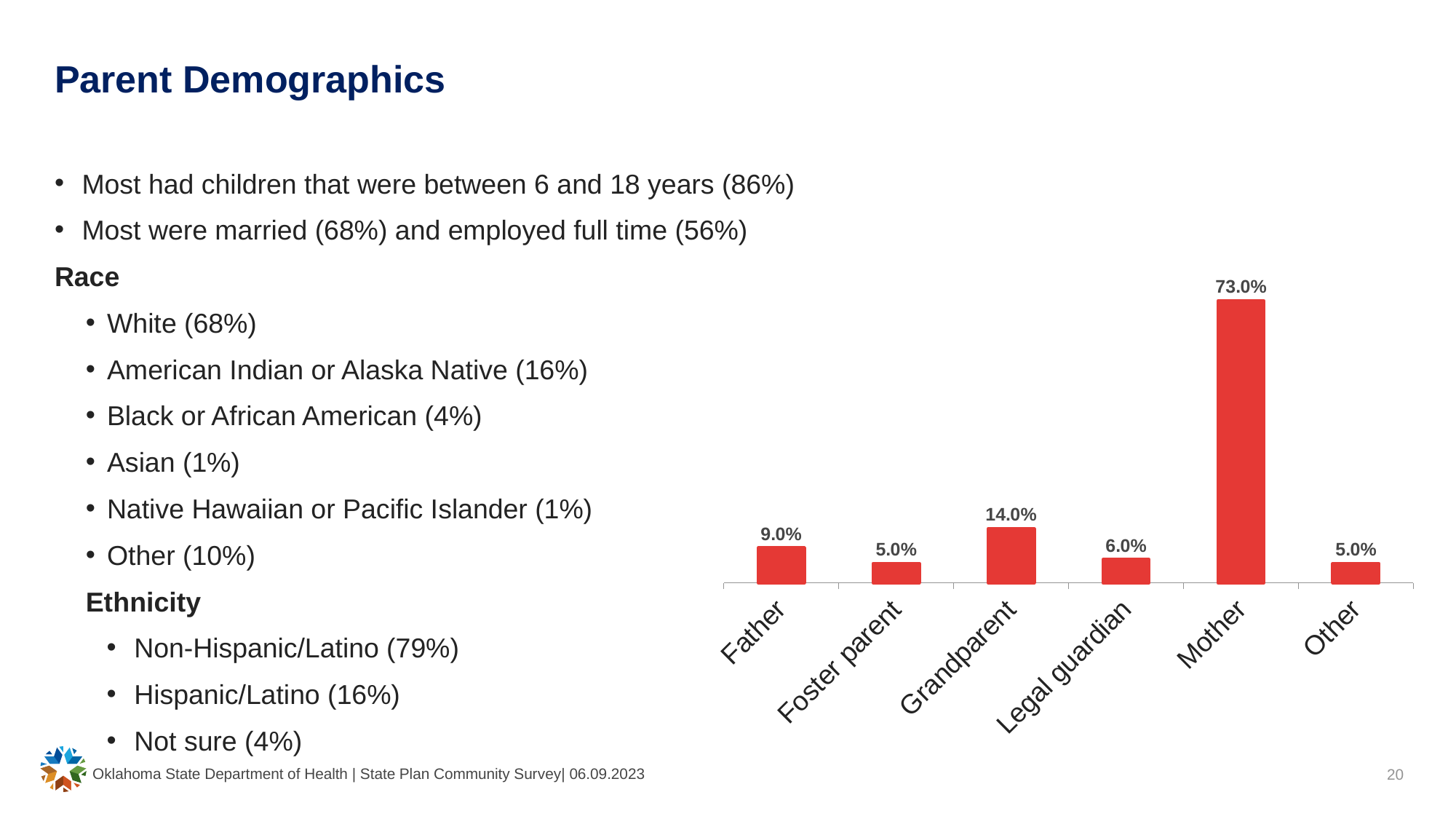
What is the value for Legal guardian in the bar chart? 6.0% What is the value for Father in the bar chart? 9.0% What is the value for Mother in the bar chart? 73.0% Which is larger, the value for Father or the value for Foster parent? Father What colour are the bars in the chart? Red Which category has the highest value in the bar chart? Mother How many categories are shown in the bar chart? 6 Which is larger, the value for Grandparent or the value for Legal guardian? Grandparent What is the value for Grandparent in the bar chart? 14.0% What kind of chart is shown on the slide? Bar chart What is the difference between the values for Father and Legal guardian? 3.0% What is the difference between the values for Mother and Grandparent? 59.0%